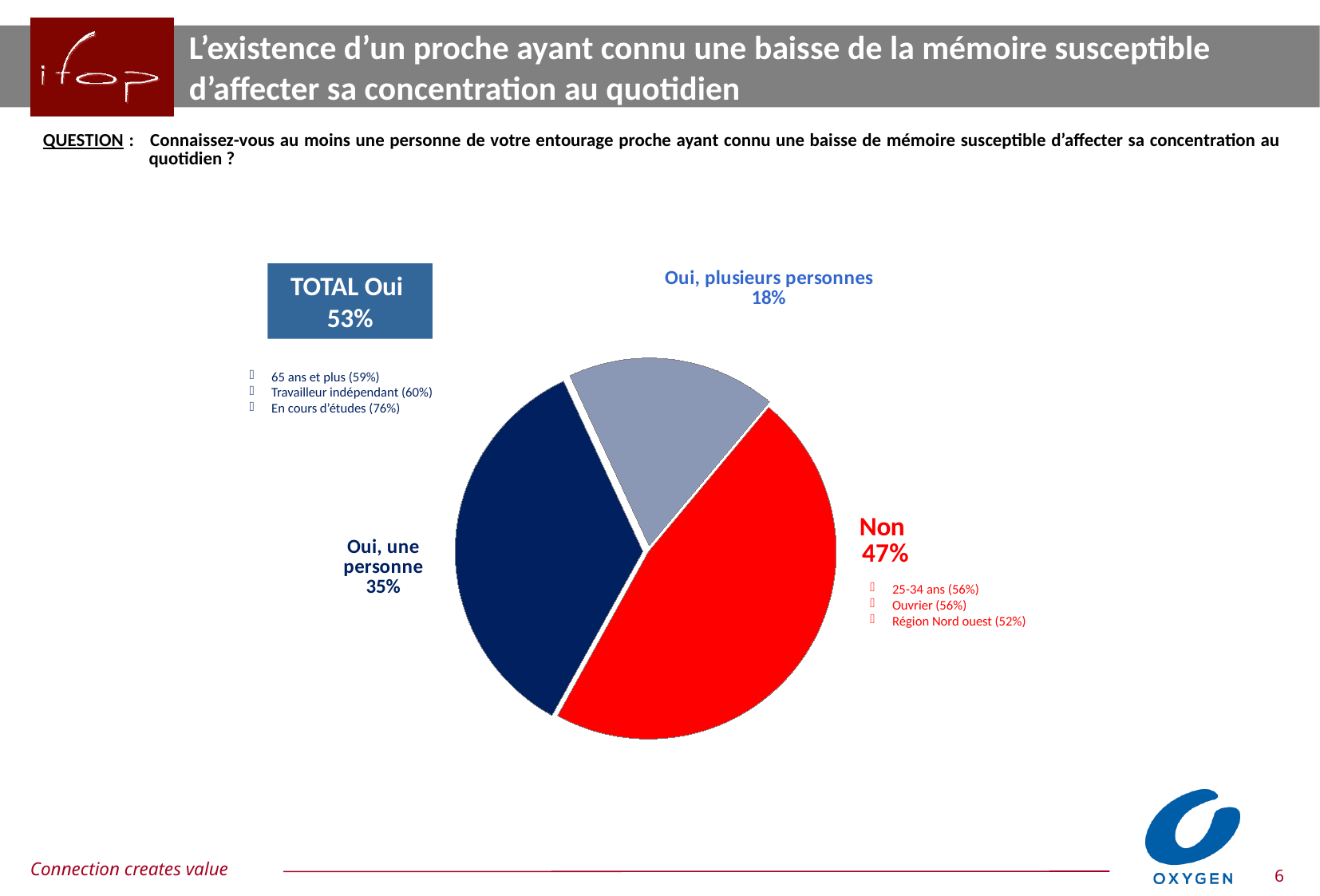
Which slice of the pie chart is the smallest? Oui, plusieurs personnes What is the value for "Non" in the pie chart? 47% What kind of chart is shown on the slide? pie chart What is the value for "Oui, une personne" in the pie chart? 35% What is the combined share of the two "Oui" slices in the pie chart? 53% What colour is the "Non" slice of the pie chart? red Which slice of the pie chart is the largest? Non How many slices does the pie chart have? 3 What is the difference between the "Non" slice and the "Oui, une personne" slice? 12% What value is shown in the "TOTAL Oui" box on the slide? 53% Which is larger in the pie chart, "Oui, une personne" or "Oui, plusieurs personnes"? Oui, une personne What is the value for "Oui, plusieurs personnes" in the pie chart? 18%